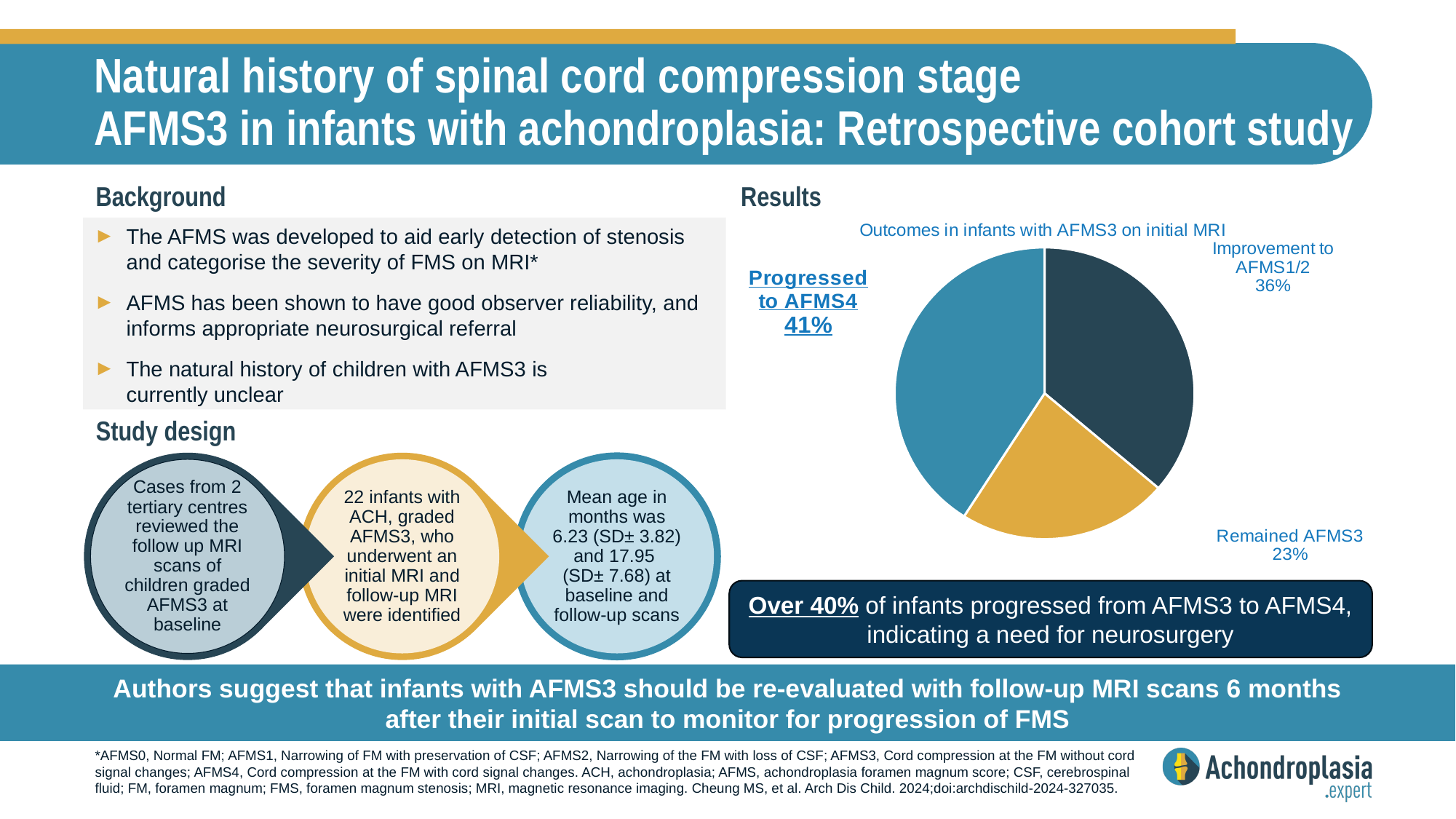
What is the difference in percentage points between infants who progressed to AFMS4 and those who remained AFMS3? 18 How many outcome categories are shown in the pie chart? 3 Which outcome category has the largest share of the pie? Progressed to AFMS4 What percentage of infants progressed to AFMS4? 41% What percentage of infants showed improvement to AFMS1/2? 36% What colour is the slice for infants who remained AFMS3? Gold/yellow What is the combined share of infants who progressed to AFMS4 and those who improved to AFMS1/2? 77% Which is larger: the share that improved to AFMS1/2 or the share that remained AFMS3? Improvement to AFMS1/2 What percentage of infants remained AFMS3? 23% What is the title of the chart? Outcomes in infants with AFMS3 on initial MRI Which outcome category has the smallest share of the pie? Remained AFMS3 What kind of chart is used to show outcomes in infants with AFMS3 on initial MRI? Pie chart